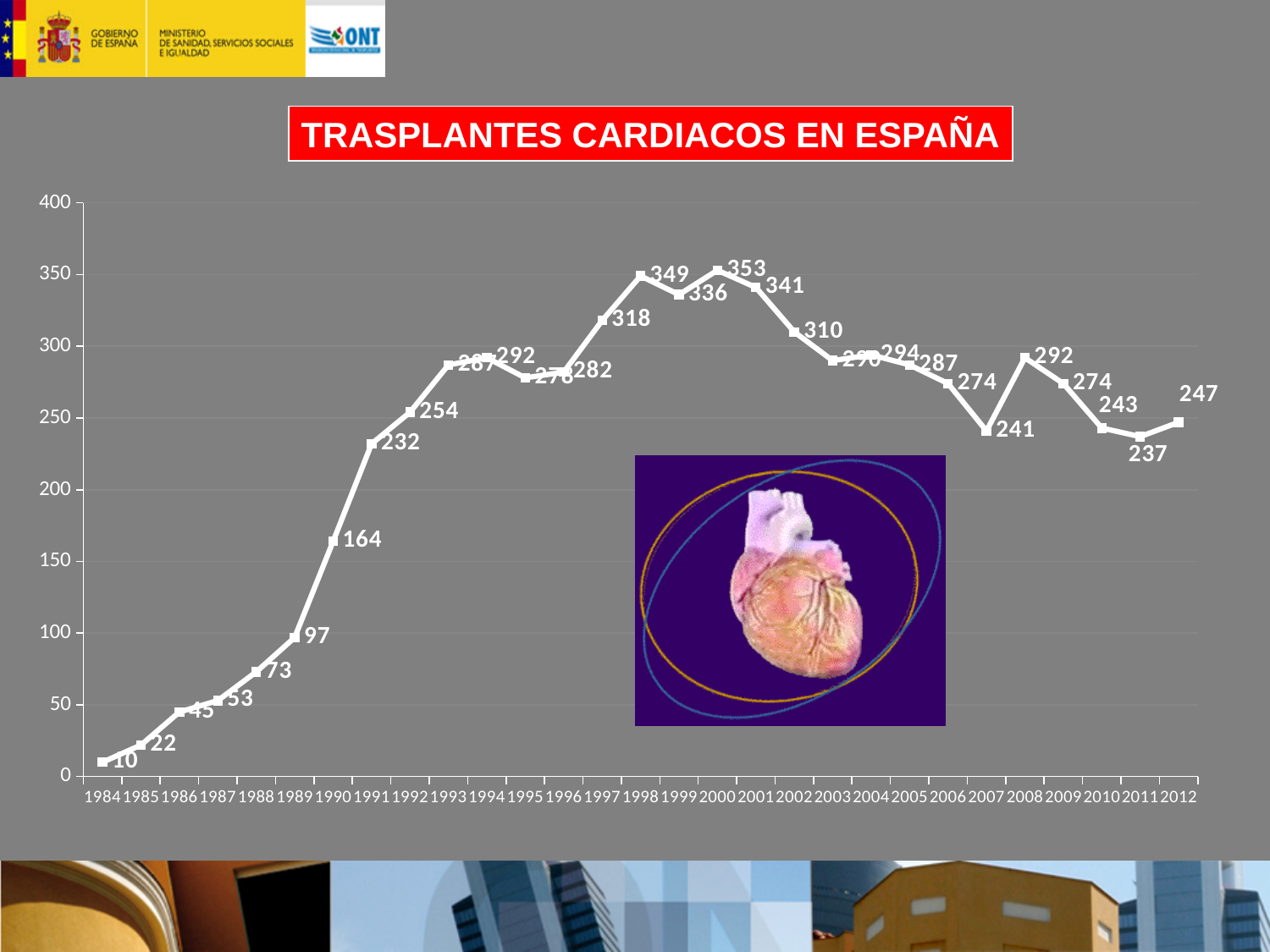
What is the title of the chart? TRASPLANTES CARDIACOS EN ESPAÑA What kind of chart is shown? line chart What is the value for 1990? 164 What is the value for 2012? 247 What is the value for 2000? 353 Is the value for 2002 greater or less than 300? greater What is the difference between the values for 1998 and 1997? 31 What is the value for 1984? 10 Which is larger, the value for 2008 or the value for 2007? 2008 Which year has the lowest value? 1984 Which year has the highest value? 2000 How many years are plotted on the x axis? 29